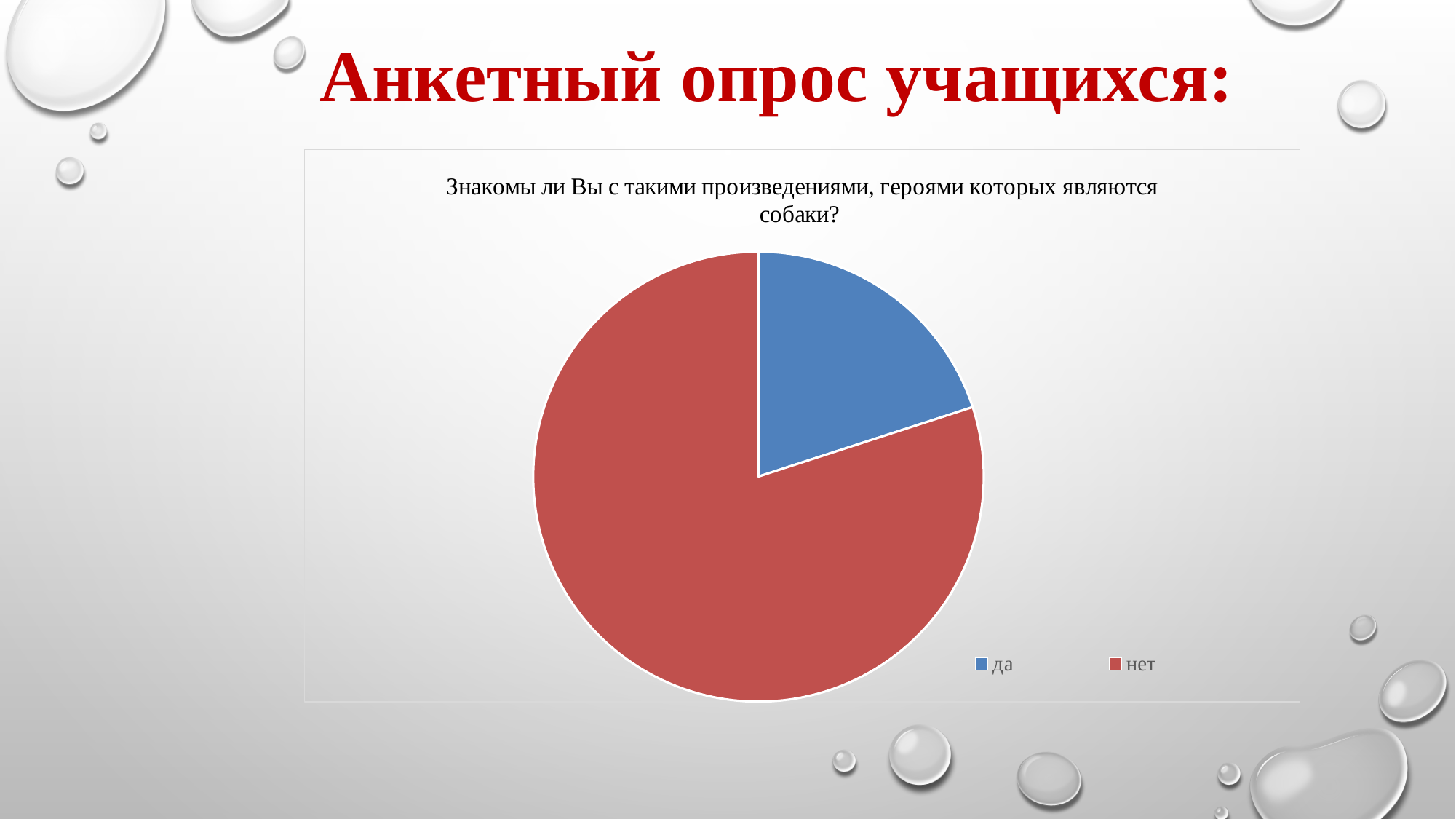
Which legend entry is shown in blue? да Which answer has the smallest slice of the pie? да What colour is the slice for "нет"? red What is the title of the chart? Знакомы ли Вы с такими произведениями, героями которых являются собаки? Which answer has the largest slice of the pie? нет How many slices does the pie chart have? 2 How many entries does the chart's legend list? 2 Which slice is larger, "да" or "нет"? нет What kind of chart is shown on the slide? pie chart